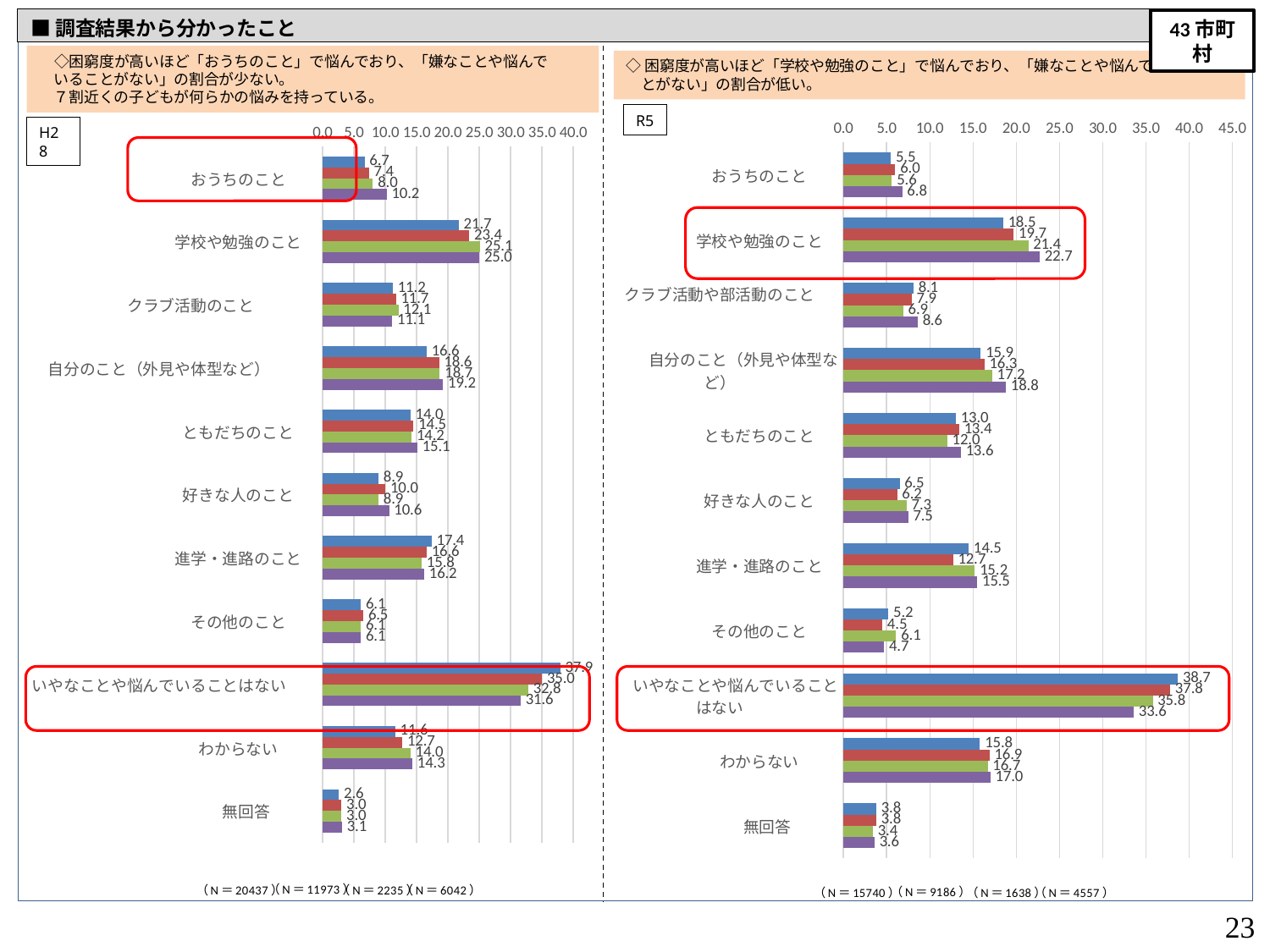
On the R5 chart on the right, what is the value of the green bar for わからない? 16.7 On the H28 chart on the left, is the value of the blue bar for いやなことや悩んでいることはない greater or less than 35.0? greater On the H28 chart on the left, which category has the highest value for the blue bar? いやなことや悩んでいることはない On the R5 chart on the right, what is the value of the blue bar for いやなことや悩んでいることはない? 38.7 On the H28 chart on the left, what is the value of the blue bar for 学校や勉強のこと? 21.7 On the R5 chart on the right, what is the difference between the blue bar and the purple bar for いやなことや悩んでいることはない? 5.1 How many categories are plotted on the R5 chart on the right of the slide? 11 On the H28 chart on the left, what is the difference between the purple bar and the blue bar for おうちのこと? 3.5 What kind of chart is the H28 chart on the left of the slide? bar chart On the R5 chart on the right, which is larger for 進学・進路のこと: the blue bar or the red bar? the blue bar On the R5 chart on the right, what is the value of the purple bar for 学校や勉強のこと? 22.7 On the H28 chart on the left, which category has the lowest value for the purple bar? 無回答